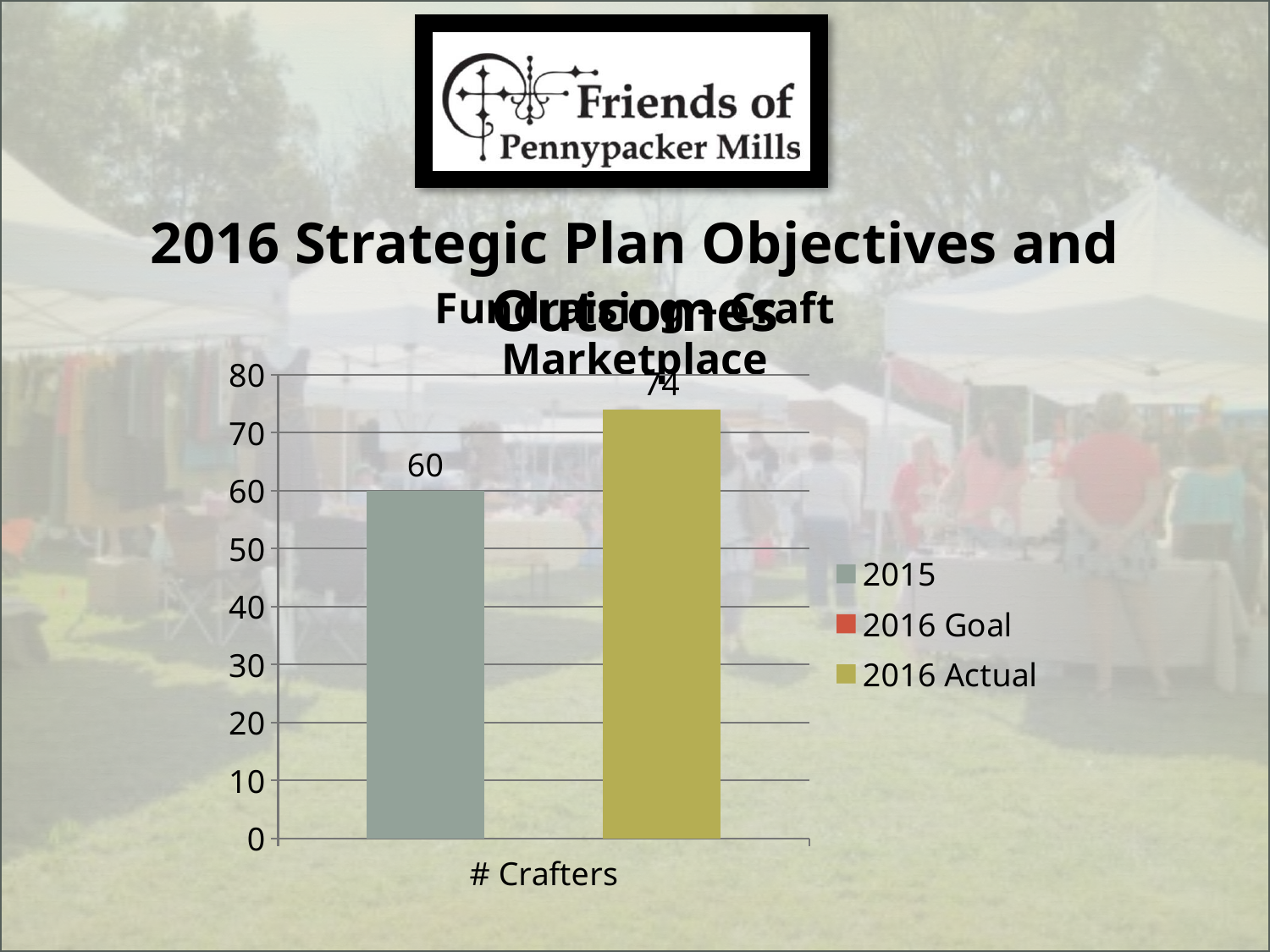
What is the category label shown on the horizontal axis? # Crafters What kind of chart is shown on the slide? bar chart What is the value of the 2016 Actual bar for # Crafters? 74 What is the difference between the 2016 Actual value and the 2015 value for # Crafters? 14 Is the 2015 value for # Crafters greater or less than 50? greater Which plotted series has the highest value for # Crafters? 2016 Actual Is the 2016 Actual value for # Crafters greater or less than 70? greater Which is larger for # Crafters, the 2015 value or the 2016 Actual value? 2016 Actual What is the value of the 2015 bar for # Crafters? 60 Which plotted series has the lowest value for # Crafters? 2015 What is the highest value shown on the vertical axis? 80 How many series does the legend list? 3